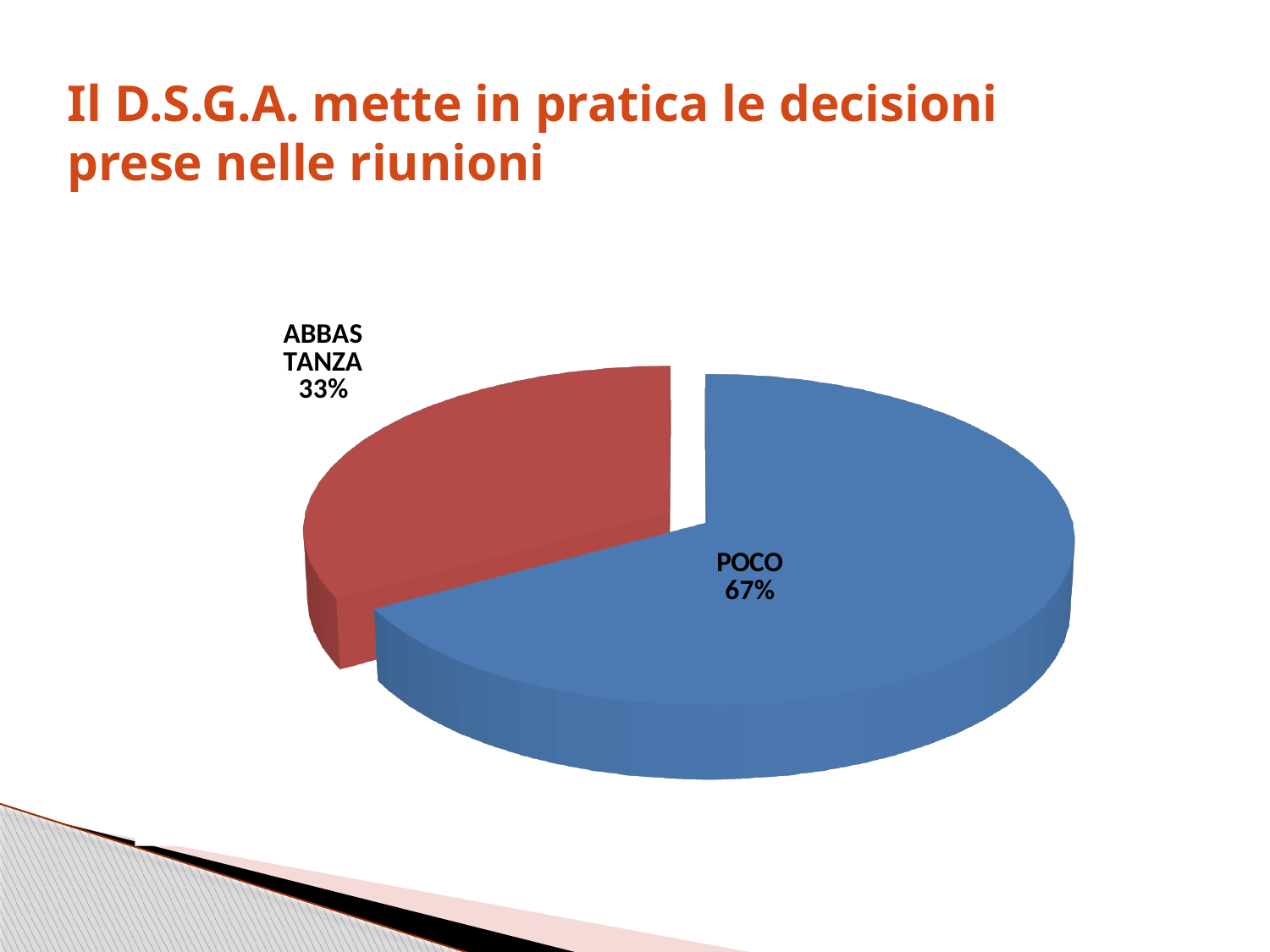
What is the difference in percentage points between POCO and ABBASTANZA? 34 Which is larger, the share for POCO or the share for ABBASTANZA? POCO Which category has the largest share of the pie? POCO What share of the pie does the ABBASTANZA slice take? 33% What is the title of the slide? Il D.S.G.A. mette in pratica le decisioni prese nelle riunioni What percentage does the ABBASTANZA slice represent? 33% Which category has the smallest share of the pie? ABBASTANZA How many slices does the pie chart have? 2 What kind of chart is shown on the slide? Pie chart What percentage does the POCO slice represent? 67% What colour is the POCO slice? Blue